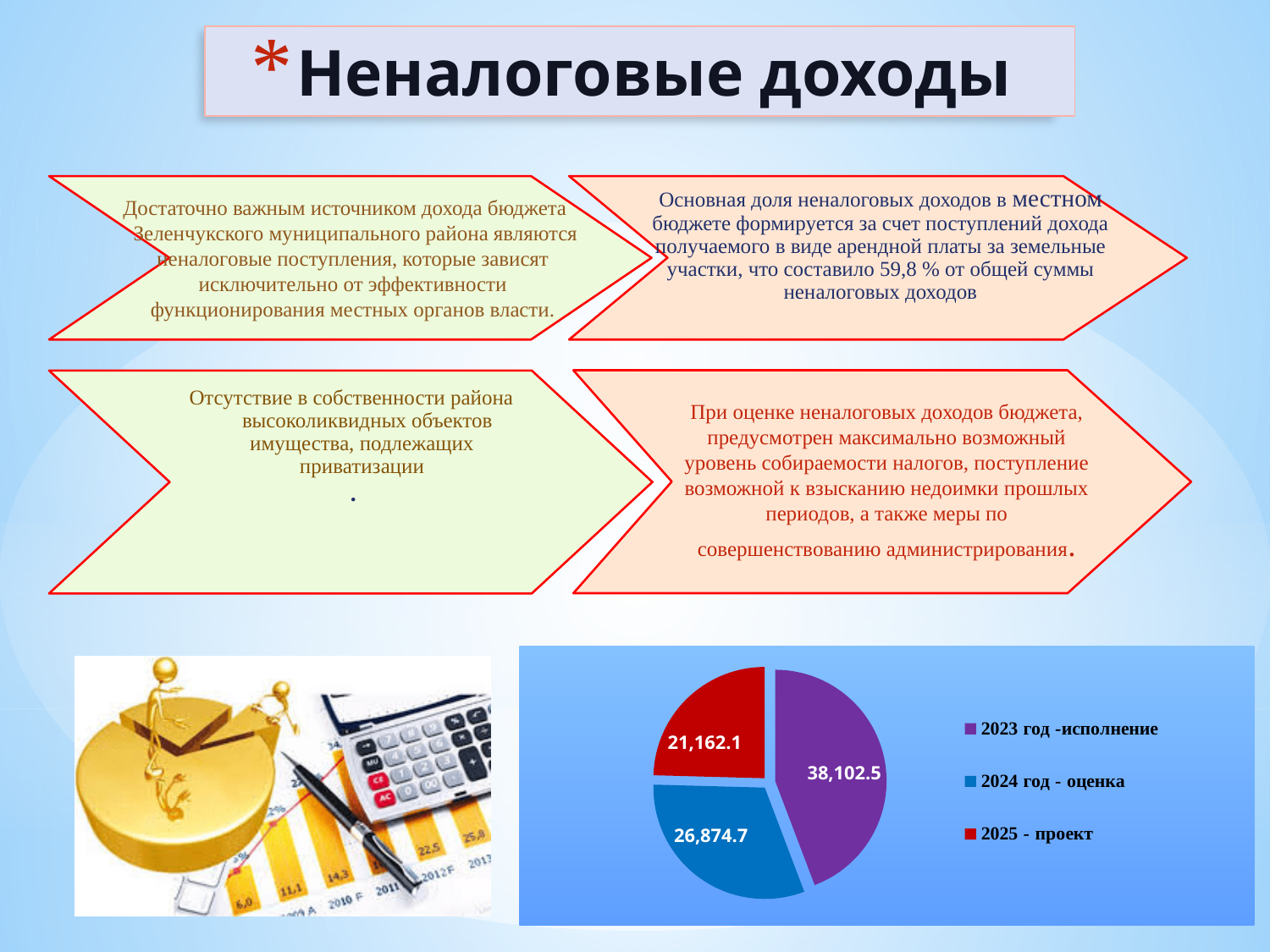
In the pie chart, what is the value for 2024 год - оценка? 26,874.7 In the pie chart, what is the value for 2025 - проект? 21,162.1 Which category has the largest slice in the pie chart? 2023 год - исполнение What kind of chart is shown at the bottom right of the slide? pie chart In the pie chart, which is larger: the value for 2024 год - оценка or the value for 2025 - проект? 2024 год - оценка In the pie chart, what is the difference between the values for 2023 год - исполнение and 2024 год - оценка? 11,227.8 How many slices does the pie chart have? 3 In the pie chart, what is the difference between the values for 2024 год - оценка and 2025 - проект? 5,712.6 In the pie chart, what is the value for 2023 год - исполнение? 38,102.5 What share of the pie chart does the 2023 год - исполнение slice represent, to one decimal place? 44.2% What colour is the slice for 2025 - проект in the pie chart? red Which category has the smallest slice in the pie chart? 2025 - проект